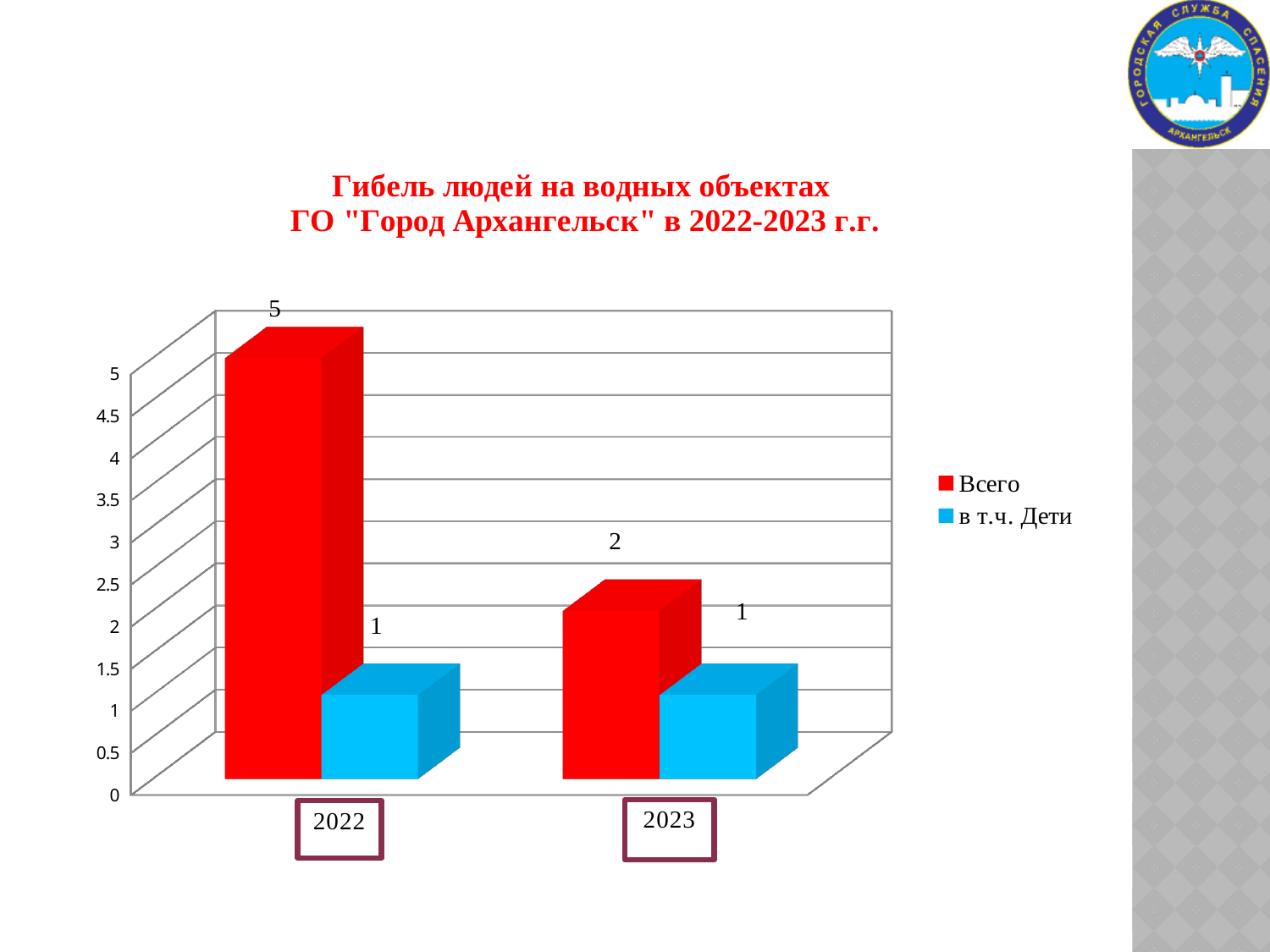
What is the difference between "Всего" and "в т.ч. Дети" in 2022? 4 What is the value for "Всего" in 2022? 5 How many years (categories) are shown on the x axis? 2 What is the value for "Всего" in 2023? 2 How many series does the legend list? 2 What is the value for "в т.ч. Дети" in 2023? 1 Which is larger in 2023: "Всего" or "в т.ч. Дети"? Всего In which year is the "Всего" value highest? 2022 What is the difference between the "Всего" values for 2022 and 2023? 3 What is the value for "в т.ч. Дети" in 2022? 1 Does the "Всего" value rise or fall from 2022 to 2023? fall What kind of chart is shown on the slide? bar chart